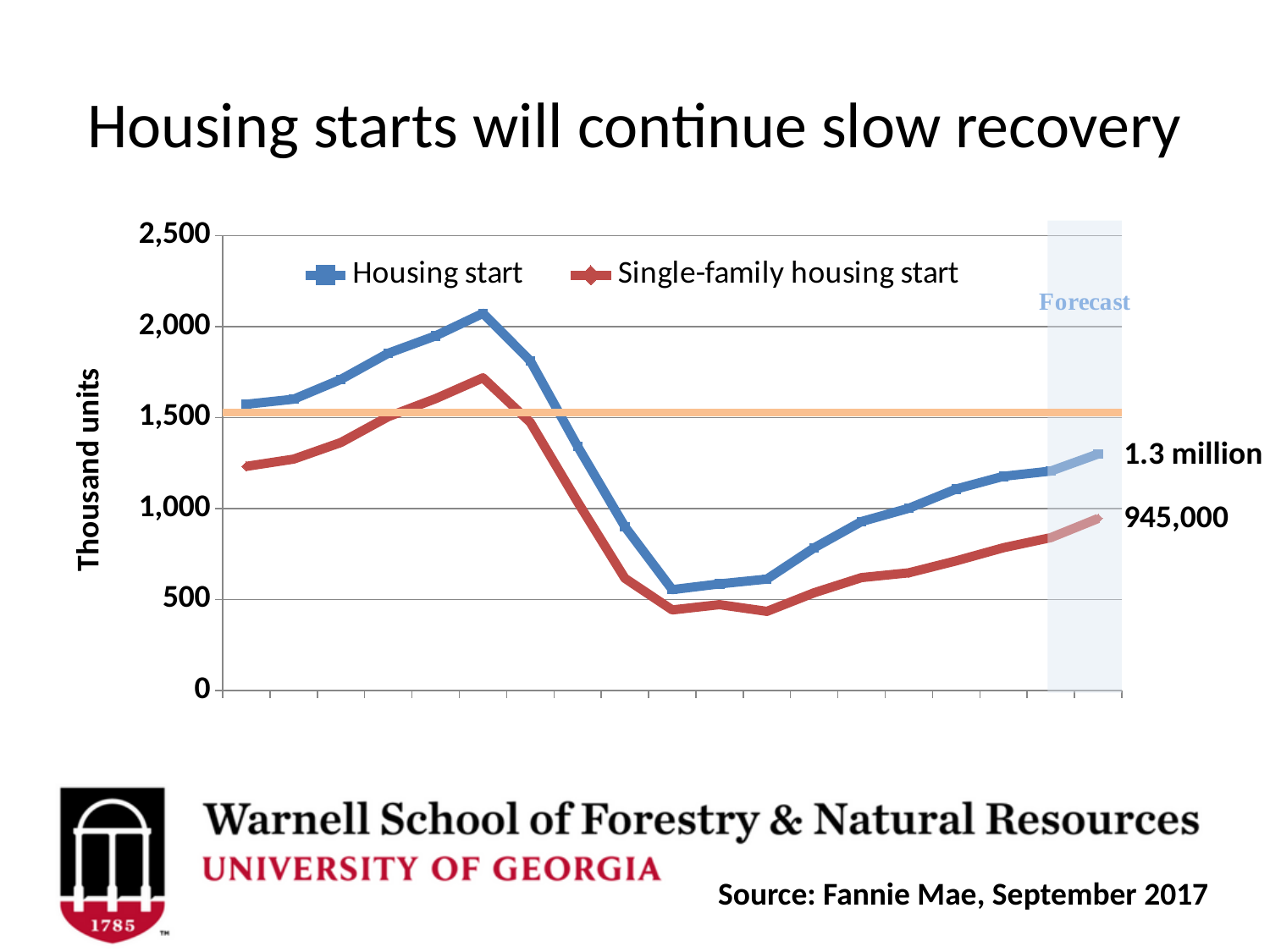
Is the peak value of the Housing start line greater or less than 2,000? greater How many series does the chart's legend list? 2 What forecast value is labelled at the end of the Single-family housing start line? 945,000 Which series has the higher values throughout the chart, Housing start or Single-family housing start? Housing start What forecast value is labelled at the end of the Housing start line? 1.3 million What is the label on the chart's vertical axis? Thousand units Is the lowest value of the Housing start line greater or less than 500? greater Which series reaches the higher peak, Housing start or Single-family housing start? Housing start Is the peak value of the Single-family housing start line greater or less than 1,500? greater What kind of chart is shown on the slide? Line chart What are the two series named in the chart's legend? Housing start and Single-family housing start